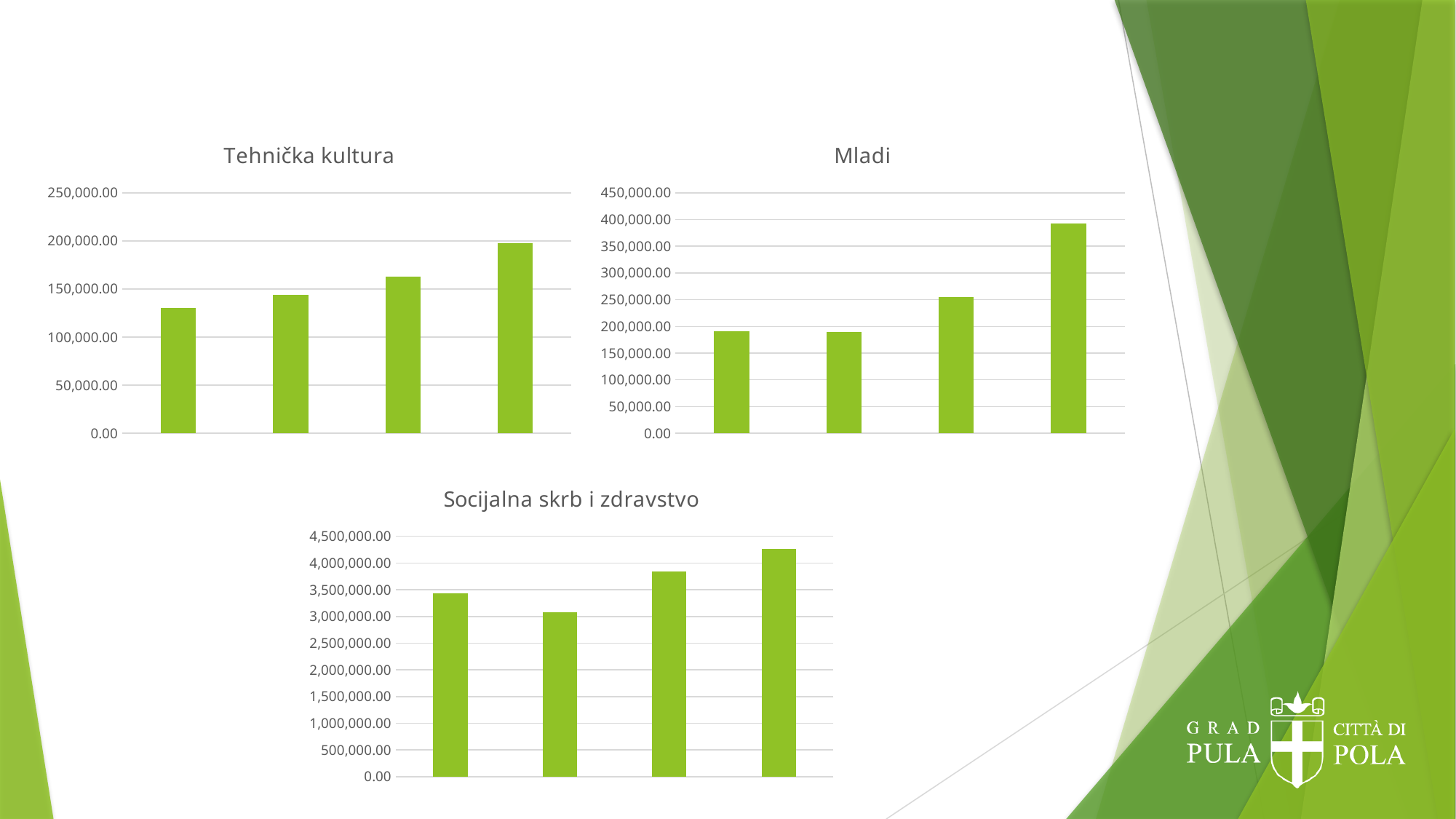
How many charts are shown on the slide? 3 In the "Tehnička kultura" chart, which bar is the highest? the fourth bar How many bars does the "Mladi" chart show? 4 In the "Socijalna skrb i zdravstvo" chart, is the value of the third bar greater or less than 4,000,000.00? less In the "Socijalna skrb i zdravstvo" chart, which bar is the lowest? the second bar In the "Mladi" chart, is the value of the fourth bar greater or less than 350,000.00? greater What kind of chart is the "Tehnička kultura" chart? bar chart In the "Mladi" chart, which bar is the highest? the fourth bar How many bars does the "Socijalna skrb i zdravstvo" chart show? 4 In the "Tehnička kultura" chart, is the value of the third bar greater or less than 150,000.00? greater In the "Tehnička kultura" chart, which bar is the lowest? the first bar Do the values in the "Tehnička kultura" chart rise or fall from left to right? rise